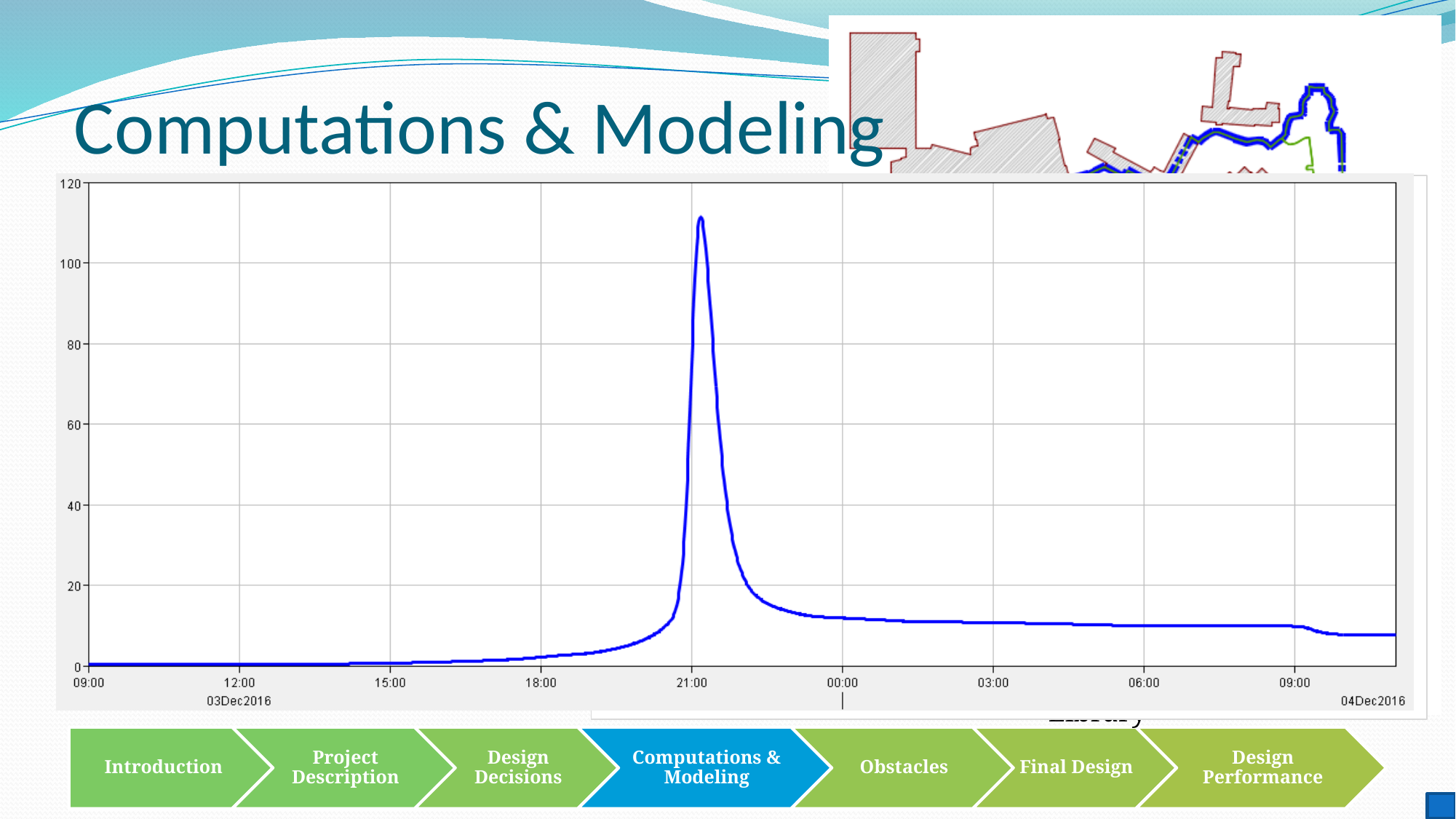
What is the highest tick value shown on the y axis? 120 Is the value of the line at 06:00 on 04Dec2016 greater or less than 20? less Near which x-axis time label does the plotted line reach its peak? 21:00 How many time labels are shown along the x axis? 9 How many lines are plotted on the chart? 1 Is the peak value of the plotted line greater or less than 100? greater What kind of chart is shown on the slide? line chart What colour is the plotted line? blue Is the value of the line at 15:00 on 03Dec2016 greater or less than 20? less Between 21:00 on 03Dec2016 and 00:00 on 04Dec2016, does the line rise or fall? fall Between 18:00 and 21:00 on 03Dec2016, does the line rise or fall? rise